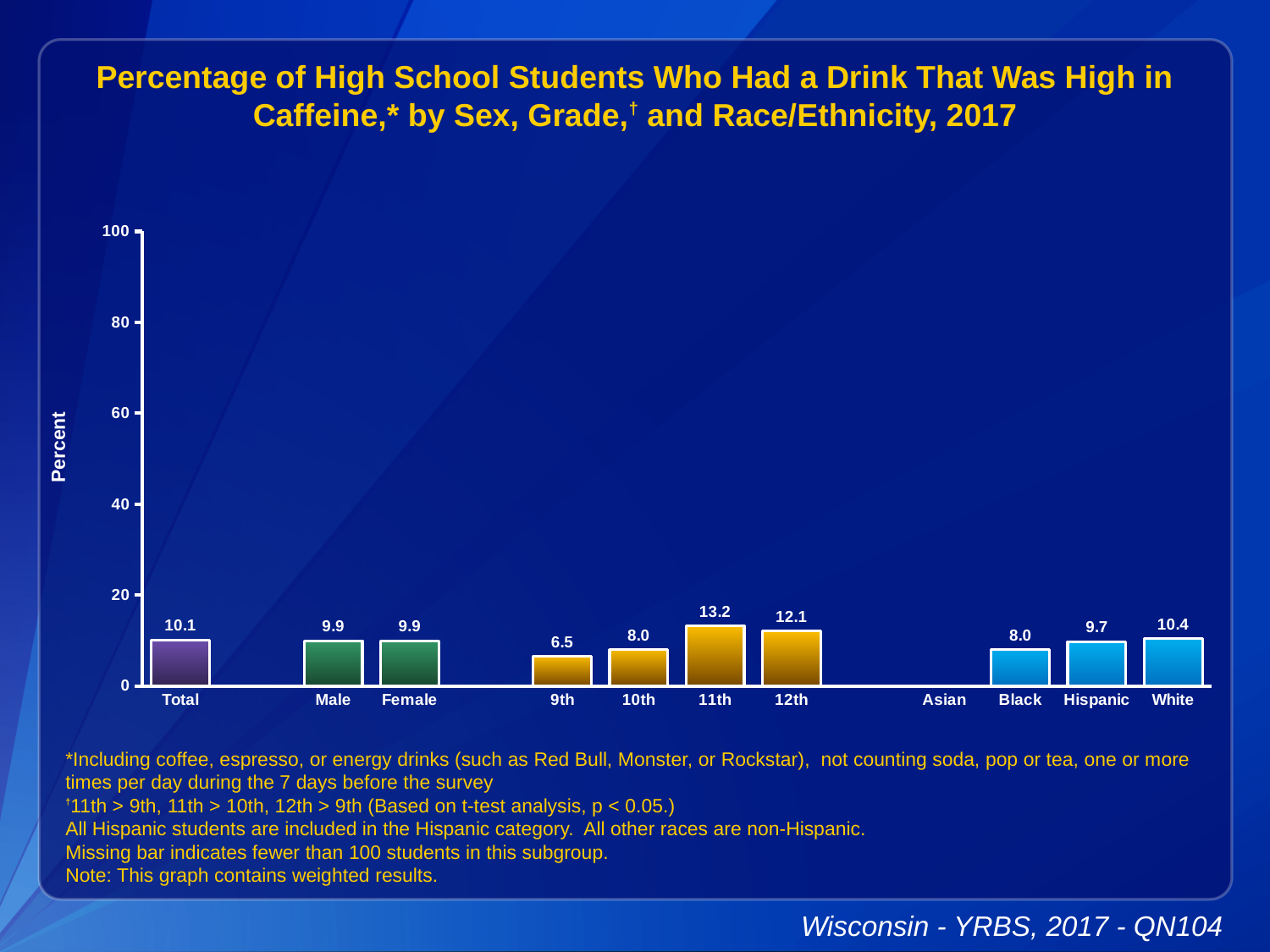
What kind of chart is shown? bar chart What is the difference between the values for 11th and 9th grade? 6.7 What is the value for 9th grade students? 6.5 Which is larger, the value for White or the value for Black? White Which category has the highest value? 11th What is the label on the y axis? Percent Is the value for 12th grade greater or less than 20? less What is the value for Hispanic students? 9.7 Which category has no bar shown? Asian How many categories have a bar plotted? 10 What is the value for Total? 10.1 Which category with a bar has the lowest value? 9th